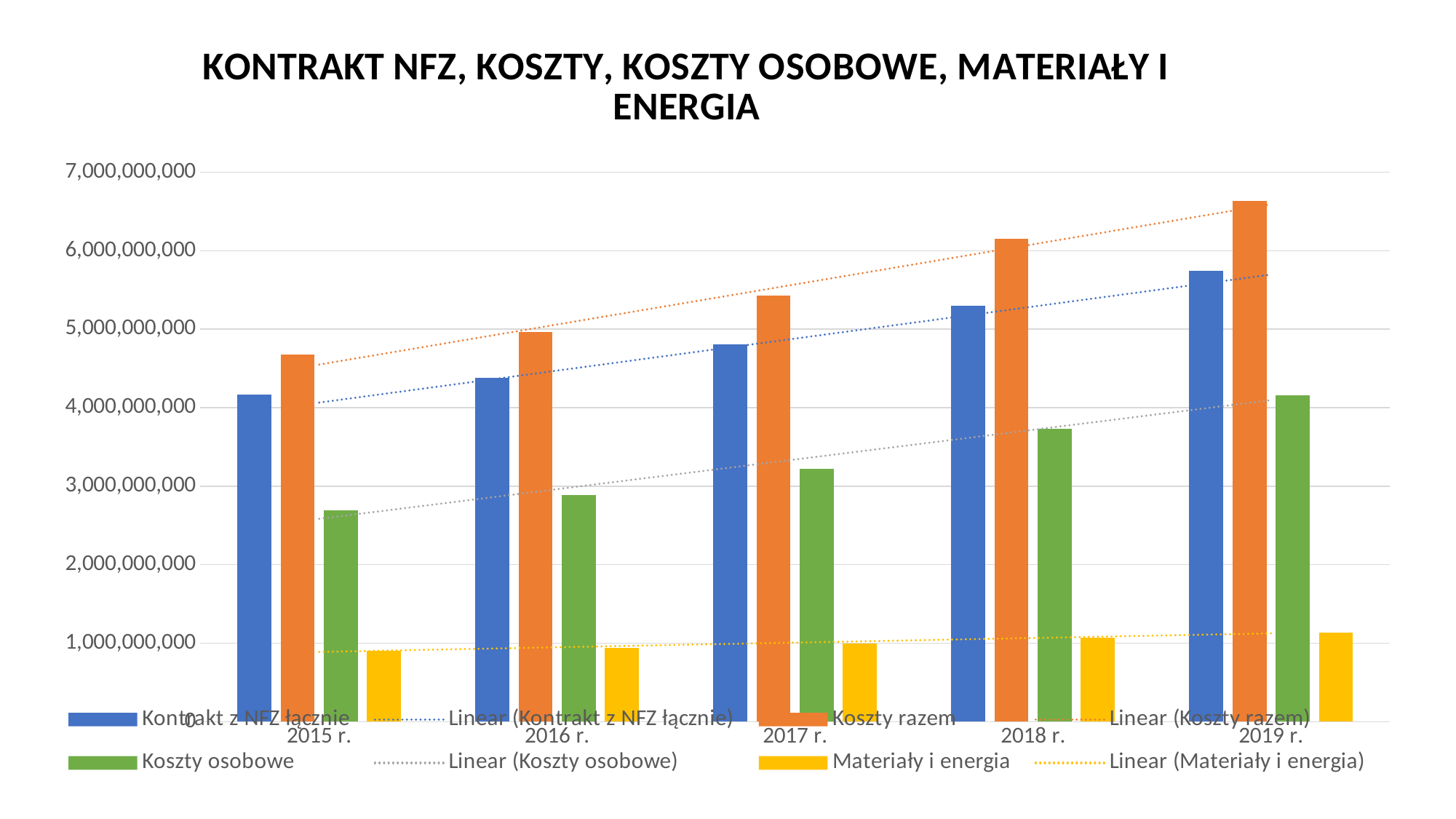
In 2017 r., which is larger: Koszty razem or Kontrakt z NFZ łącznie? Koszty razem Is the value for Materiały i energia in 2019 r. greater or less than 1,000,000,000? greater How many entries does the legend list? 8 In which year is Materiały i energia lowest? 2015 r. In which year is Koszty razem highest? 2019 r. Does Kontrakt z NFZ łącznie rise or fall from 2015 r. to 2019 r.? rise Is the value for Kontrakt z NFZ łącznie in 2015 r. greater or less than 4,000,000,000? greater Is the value for Materiały i energia in 2015 r. greater or less than 1,000,000,000? less What kind of chart is shown on the slide? bar chart How many years are shown on the x axis? 5